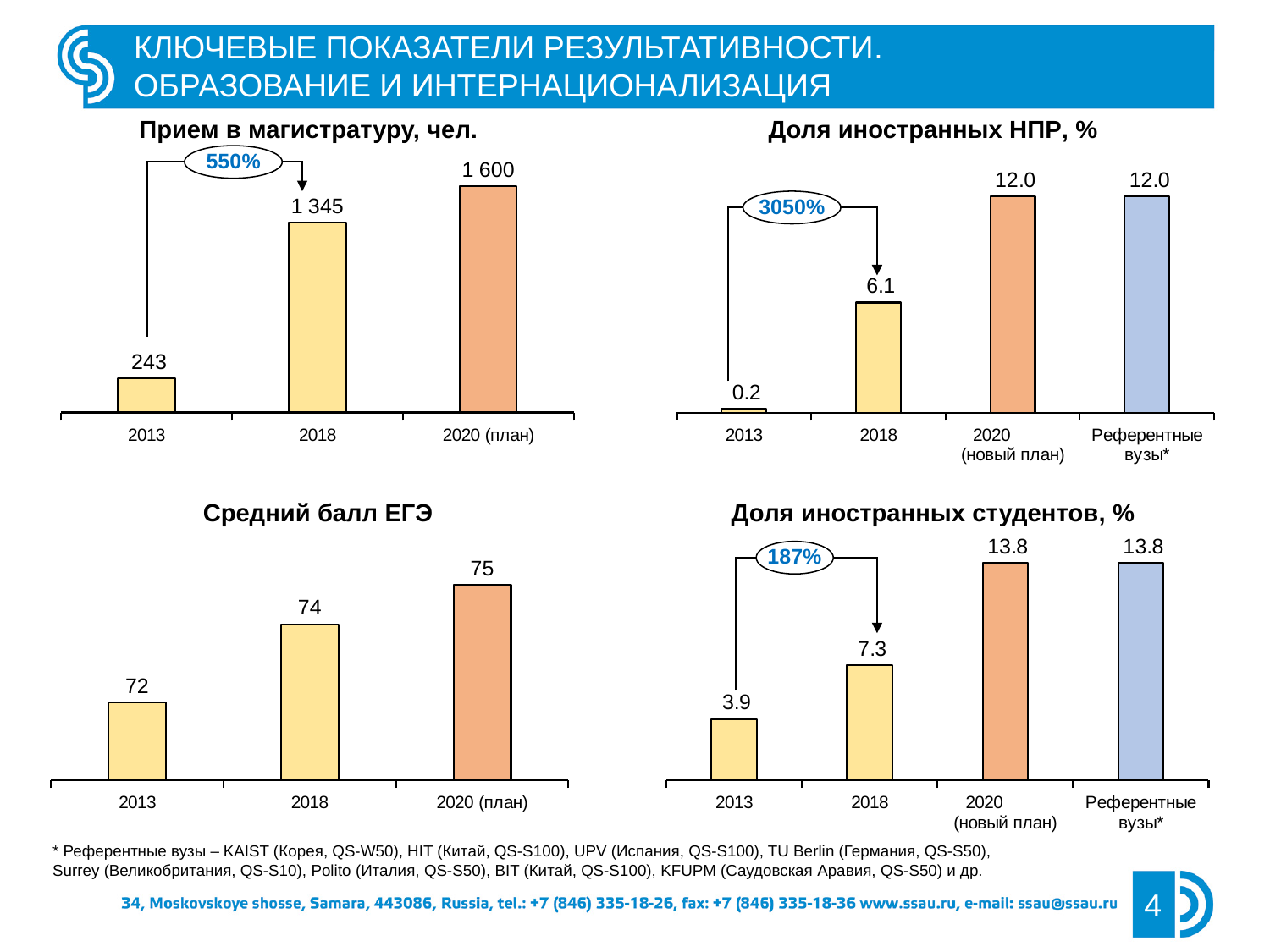
In the chart titled "Средний балл ЕГЭ", do the values rise or fall from 2013 to 2020 (план)? rise In the chart titled "Прием в магистратуру, чел.", what is the value for 2018? 1 345 In the chart titled "Доля иностранных студентов, %", which is larger: the value for 2018 or the value for 2020 (новый план)? 2020 (новый план) In the chart titled "Средний балл ЕГЭ", what is the value for 2020 (план)? 75 In the chart titled "Доля иностранных НПР, %", what is the value for 2018? 6.1 In the chart titled "Доля иностранных НПР, %", how many bars are plotted? 4 In the chart titled "Прием в магистратуру, чел.", which category has the lowest value? 2013 In the chart titled "Доля иностранных студентов, %", what is the value for 2013? 3.9 What kind of chart is the one titled "Доля иностранных студентов, %"? bar chart In the chart titled "Прием в магистратуру, чел.", what is the difference between the 2020 (план) value and the 2013 value? 1 357 In the chart titled "Средний балл ЕГЭ", what is the difference between the 2018 value and the 2013 value? 2 In the chart titled "Доля иностранных НПР, %", what is the value for 2013? 0.2